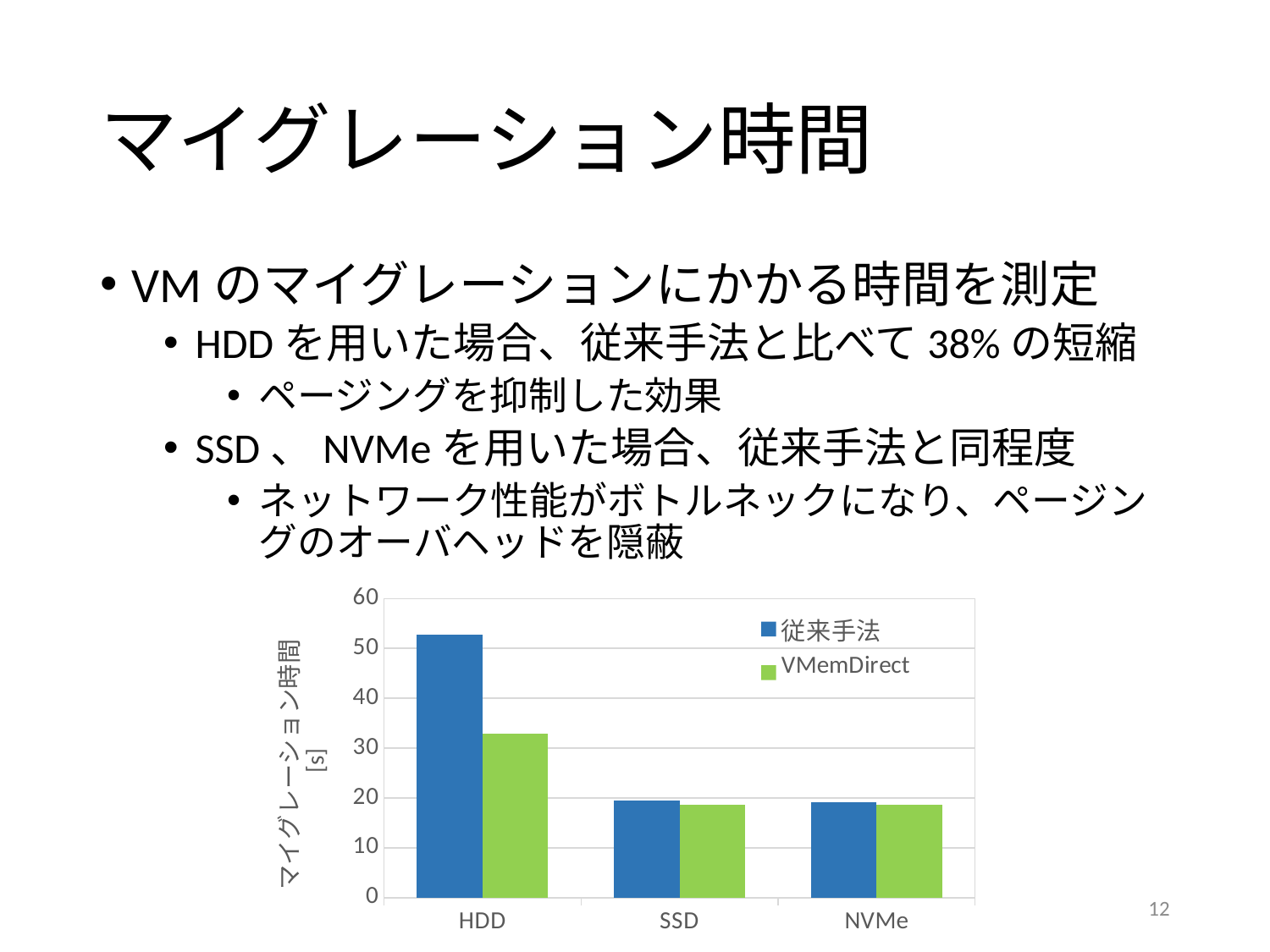
Which category has the highest value for 従来手法? HDD Is the value for VMemDirect at HDD greater or less than 30? greater Which category has the highest value for VMemDirect? HDD How many series does the chart's legend list? 2 Is the value for 従来手法 at SSD greater or less than 30? less What is the label of the chart's vertical axis? マイグレーション時間 [s] Is the value for VMemDirect at NVMe greater or less than 30? less What kind of chart is shown on the slide? bar chart Which colour represents VMemDirect in the chart? green For HDD, which is larger: 従来手法 or VMemDirect? 従来手法 How many categories are shown on the x axis of the chart? 3